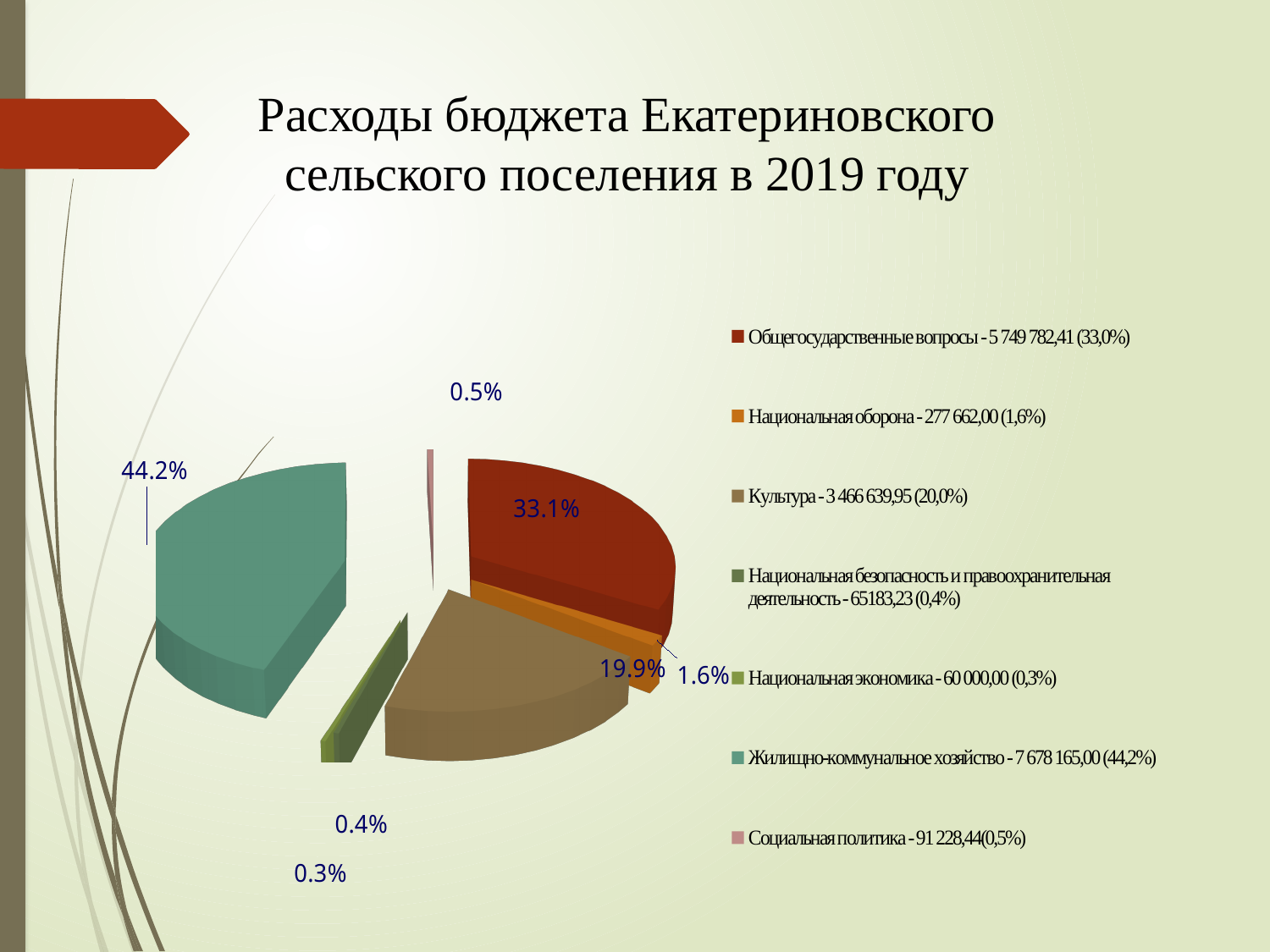
What percentage label is shown on the pie chart for the Социальная политика slice? 0.5% Which category has the largest slice of the pie chart? Жилищно-коммунальное хозяйство According to the legend, what is the amount for Национальная оборона? 277 662,00 Which category has the smallest slice of the pie chart? Национальная экономика According to the legend, what is the amount for Национальная безопасность и правоохранительная деятельность? 65183,23 Which slice is larger: Общегосударственные вопросы or Культура? Общегосударственные вопросы How many categories does the legend of the pie chart list? 7 What kind of chart is shown on the slide? pie chart According to the legend, what is the amount for Культура? 3 466 639,95 What is the title of the slide containing the pie chart? Расходы бюджета Екатериновского сельского поселения в 2019 году What percentage label is shown on the pie chart for the Жилищно-коммунальное хозяйство slice? 44.2% What is the difference in percentage points between the Национальная оборона slice (1.6%) and the Социальная политика slice (0.5%)? 1.1%